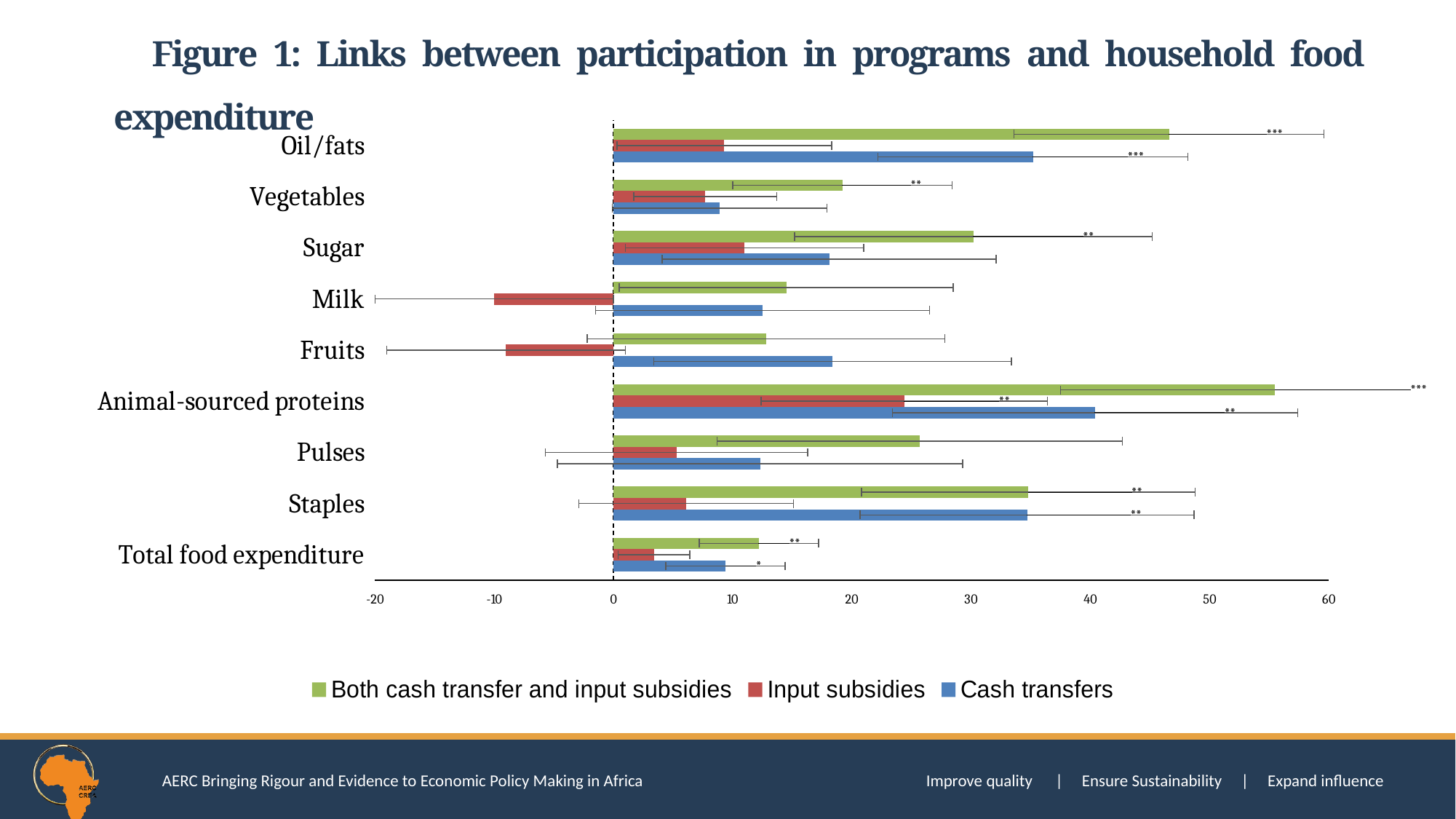
What is the title of the figure on the slide? Figure 1: Links between participation in programs and household food expenditure Which category has the highest value for the 'Both cash transfer and input subsidies' series? Animal-sourced proteins Is the value for Oil/fats in the 'Both cash transfer and input subsidies' series greater or less than 40? greater Is the value for Fruits in the 'Input subsidies' series greater or less than 0? less What colour represents the 'Cash transfers' series in the chart? blue Which category has the lowest value for the 'Input subsidies' series? Milk For Vegetables, which series has the larger value: 'Both cash transfer and input subsidies' or 'Cash transfers'? Both cash transfer and input subsidies What kind of chart is shown on the slide? bar chart How many series does the legend list? 3 For Staples, which series has the larger value: 'Input subsidies' or 'Cash transfers'? Cash transfers How many food categories are listed on the vertical axis of the chart? 9